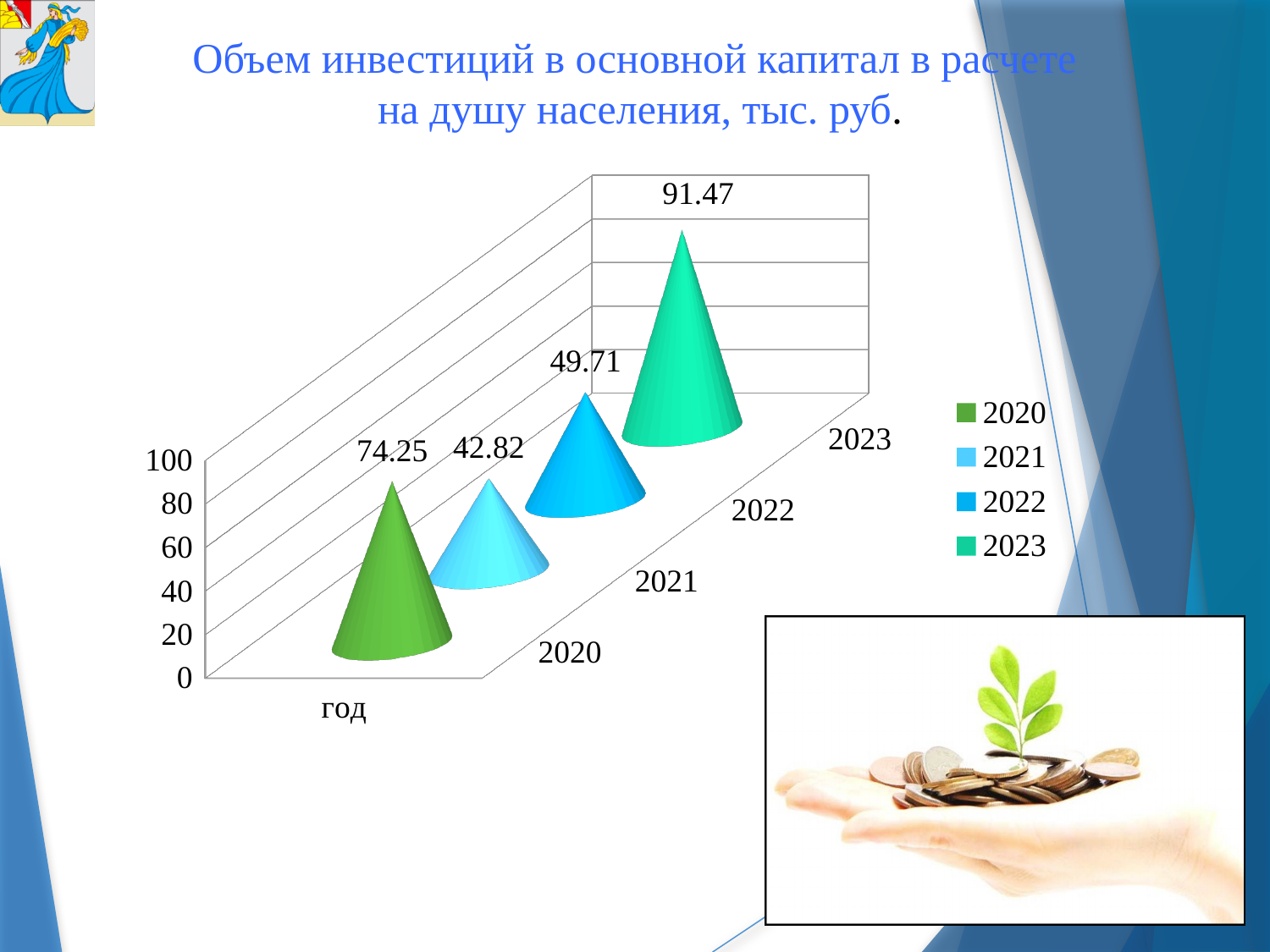
How many years are shown on the chart? 4 What is the value for 2020? 74.25 What is the title of the chart? Объем инвестиций в основной капитал в расчете на душу населения, тыс. руб. Which year has the highest value? 2023 What is the value for 2021? 42.82 How many entries does the legend list? 4 Which year has the lowest value? 2021 Which is larger, the value for 2020 or the value for 2022? 2020 What is the value for 2023? 91.47 What is the difference between the values for 2022 and 2021? 6.89 What is the difference between the values for 2023 and 2020? 17.22 What is the value for 2022? 49.71